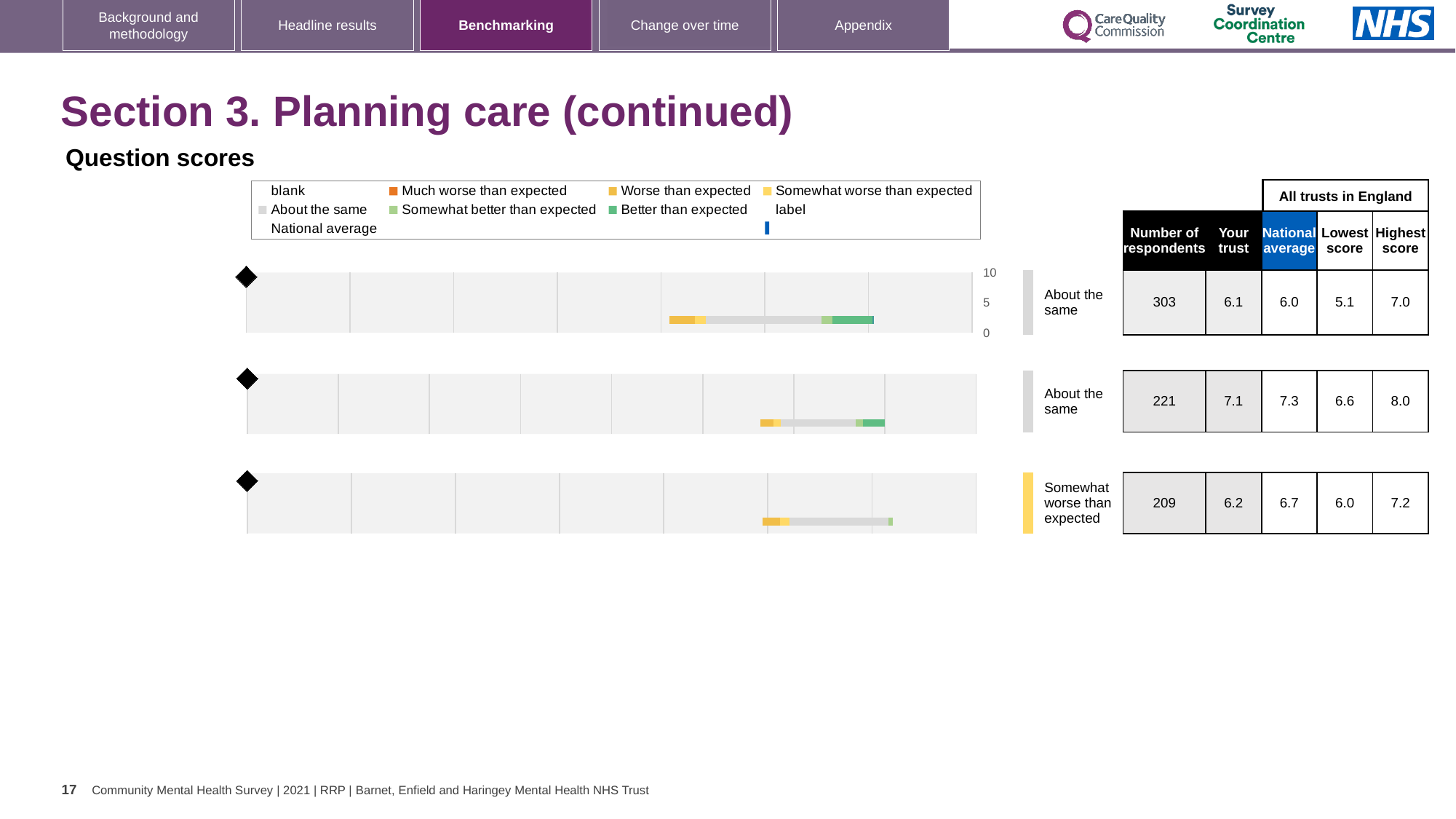
For the middle chart, which is larger: the 'Your trust' score or the national average? National average What kind of chart is the top chart on the slide? bar chart Which chart (top, middle or bottom) has the highest 'Your trust' score? middle For the top chart, what is the difference between the highest score and the lowest score? 1.9 What benchmark category label is shown next to the bottom chart? Somewhat worse than expected For the bottom chart, how much higher is the national average than the 'Your trust' score? 0.5 For the top chart, what is the 'Your trust' score? 6.1 For the bottom chart, what is the lowest score among all trusts in England? 6.0 For the middle chart, what is the national average score? 7.3 For the bottom chart, how many respondents are there? 209 How many benchmarking charts are shown on the slide? 3 Is the 'Your trust' value in the top chart greater or less than 5? greater